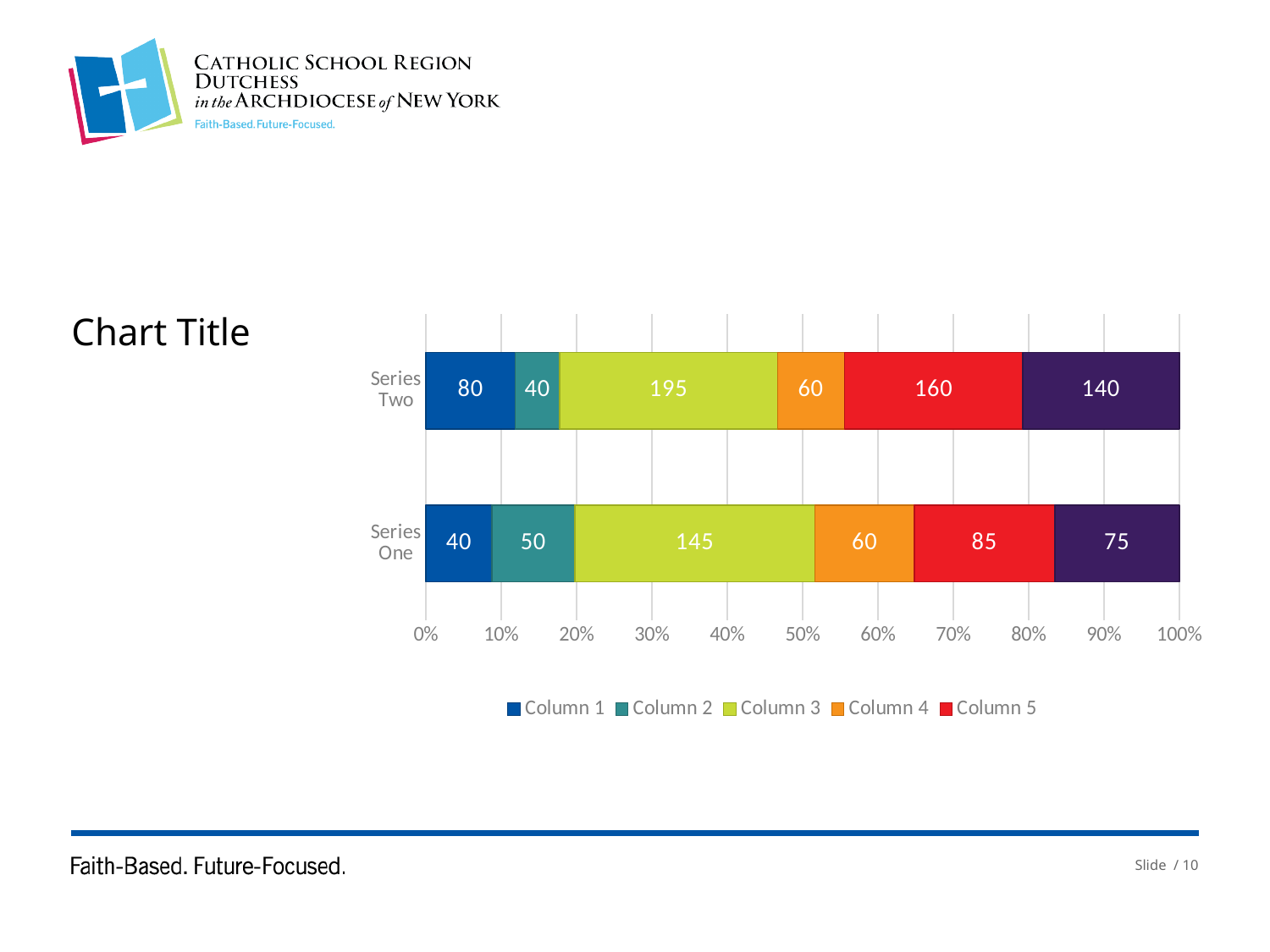
What is the title of the chart? Chart Title How many entries does the legend list? 5 What is the total of all labelled segments in the Series One bar? 455 Which legend column has the smallest value in the Series Two bar? Column 2 What kind of chart is shown on the slide? Stacked bar chart What is the value of Column 1 for Series Two? 80 Which has the larger Column 2 value, Series One or Series Two? Series One What is the value of Column 5 for Series One? 85 How many bars (categories) are shown in the chart? 2 What is the difference between the Column 5 values for Series Two and Series One? 75 Which legend column has the largest value in the Series One bar? Column 3 What is the value of Column 3 for Series Two? 195